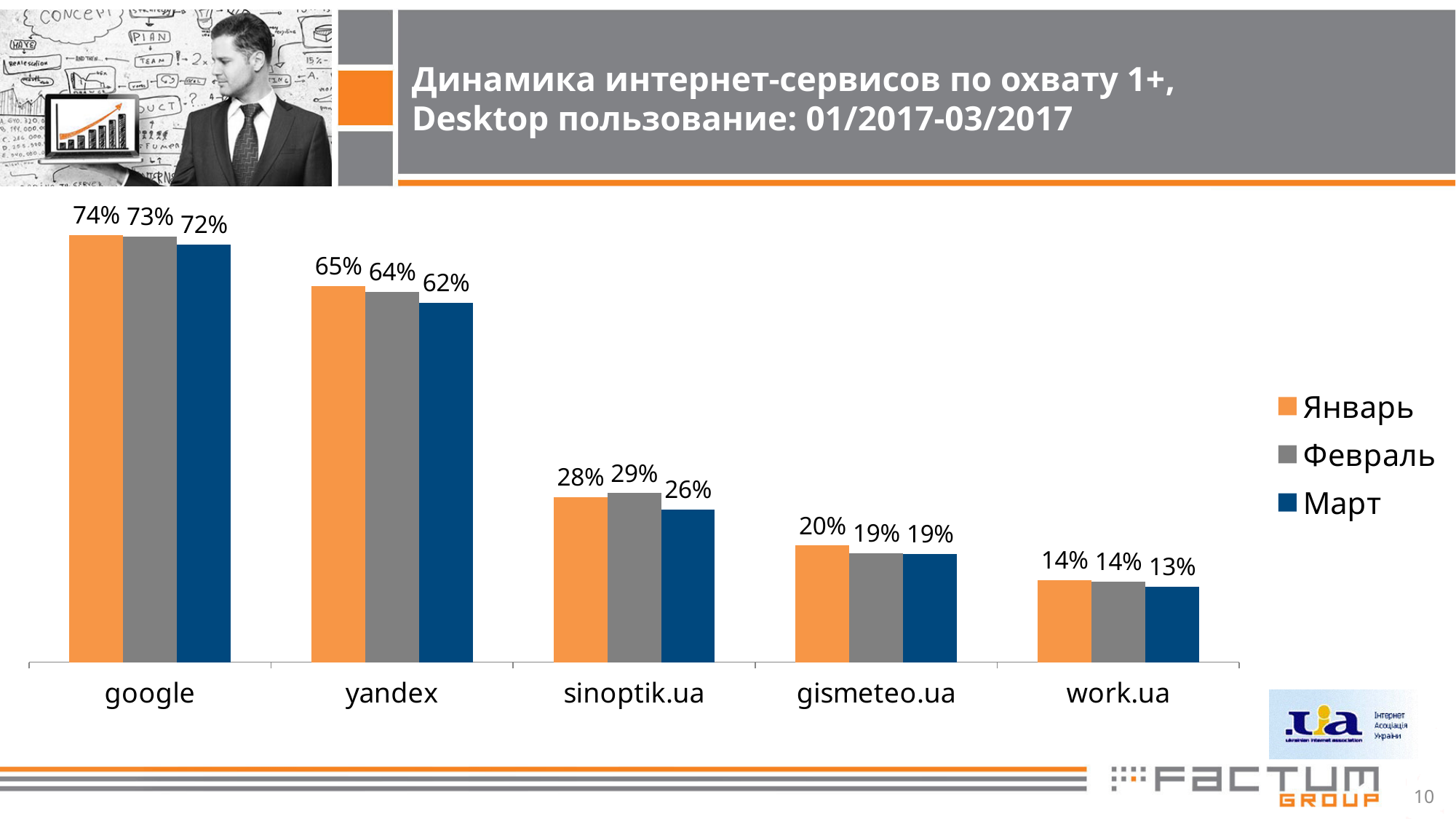
How many categories are shown on the x axis? 5 What is the value for google in Январь? 74% What kind of chart is shown on the slide? bar chart What is the value for work.ua in Март? 13% What is the difference between the Январь and Март values for yandex? 3% What is the value for sinoptik.ua in Март? 26% Which category has the highest value in Январь? google Which is larger for sinoptik.ua: the Январь value or the Февраль value? Февраль How many series does the legend list? 3 What is the value for yandex in Февраль? 64% Which colour represents Март in the legend? dark blue Which category has the lowest value in Март? work.ua